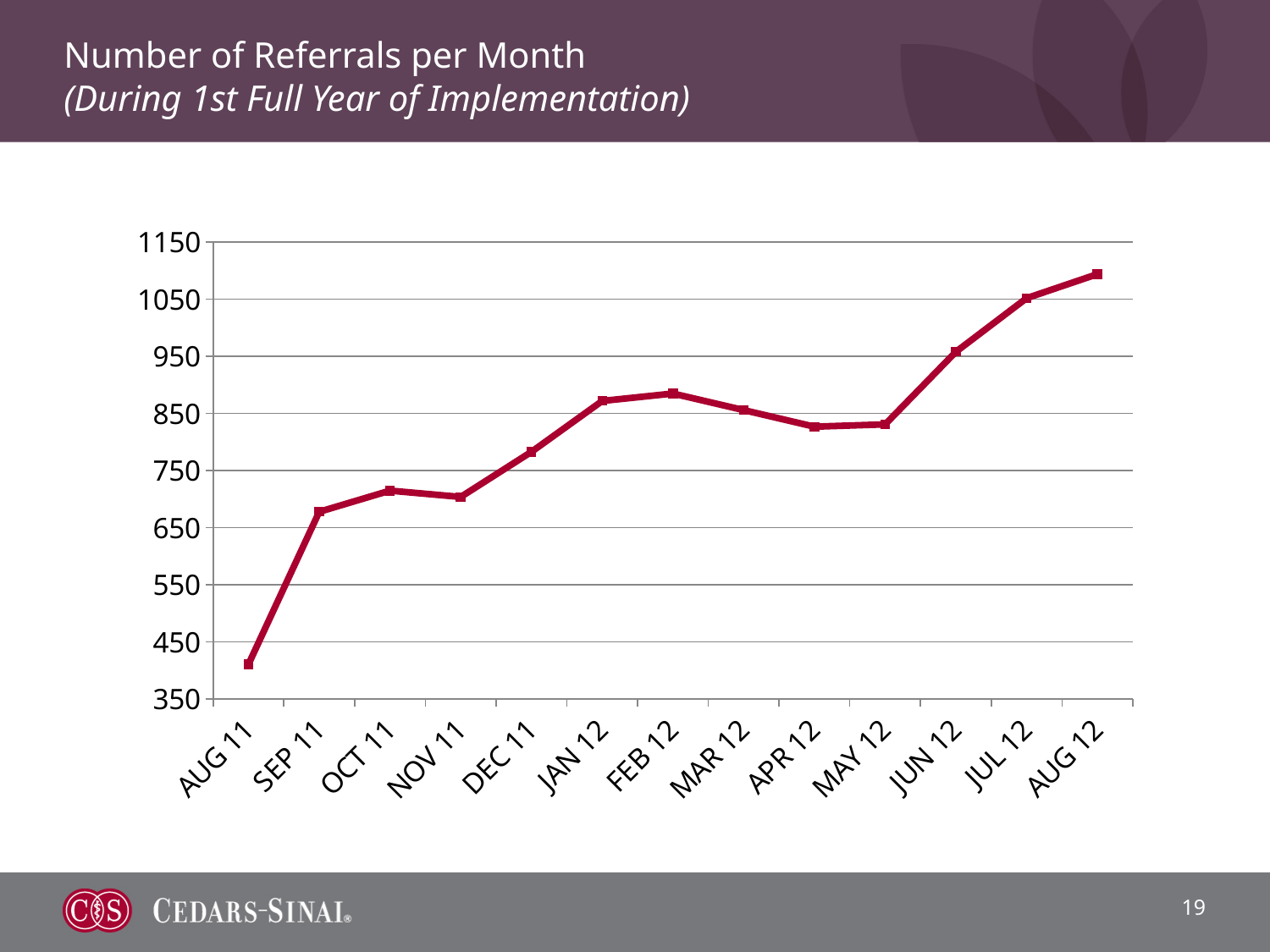
What kind of chart is shown on the slide? line chart Which month has more referrals, SEP 11 or DEC 11? DEC 11 Which month has more referrals, JAN 12 or APR 12? JAN 12 Which month has the highest number of referrals? AUG 12 How many months are plotted on the x axis? 13 What is the title of the chart on the slide? Number of Referrals per Month (During 1st Full Year of Implementation) Overall, do the number of referrals rise or fall from AUG 11 to AUG 12? rise Is the value for AUG 11 greater or less than 450? less Is the value for JUL 12 greater or less than 950? greater Which month has the lowest number of referrals? AUG 11 Is the value for NOV 11 greater or less than 750? less